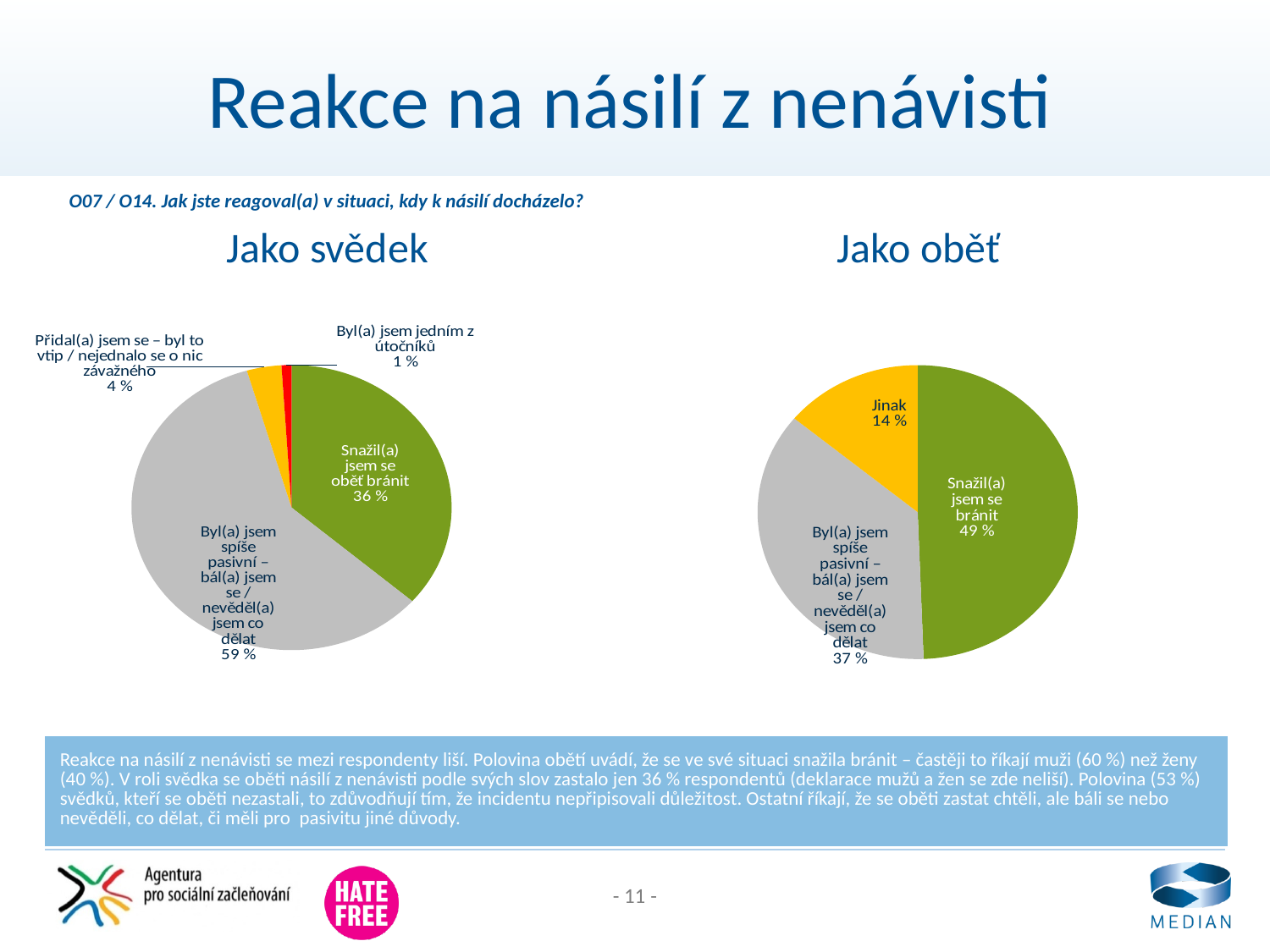
How many slices does the 'Jako svědek' pie chart have? 4 In the 'Jako svědek' pie chart, what share is labelled 'Byl(a) jsem jedním z útočníků'? 1 % In the 'Jako oběť' pie chart, what is the difference between the 'Snažil(a) jsem se bránit' share and the 'Byl(a) jsem spíše pasivní' share? 12 % In the 'Jako oběť' pie chart, which category has the smallest share? Jinak In the 'Jako oběť' pie chart, what share of respondents answered 'Jinak'? 14 % In the 'Jako svědek' pie chart, what share of respondents said 'Snažil(a) jsem se oběť bránit'? 36 % In the 'Jako oběť' pie chart, what share of respondents said 'Snažil(a) jsem se bránit'? 49 % What type of chart is used for 'Jako oběť'? Pie chart In the 'Jako svědek' pie chart, what is the difference between the 'Byl(a) jsem spíše pasivní' share and the 'Snažil(a) jsem se oběť bránit' share? 23 % Which is larger: the 'Snažil(a) jsem se bránit' share in the 'Jako oběť' chart or the 'Snažil(a) jsem se oběť bránit' share in the 'Jako svědek' chart? Jako oběť In the 'Jako svědek' pie chart, which category has the smallest share? Byl(a) jsem jedním z útočníků In the 'Jako svědek' pie chart, which category has the largest share? Byl(a) jsem spíše pasivní – bál(a) jsem se / nevěděl(a) jsem co dělat